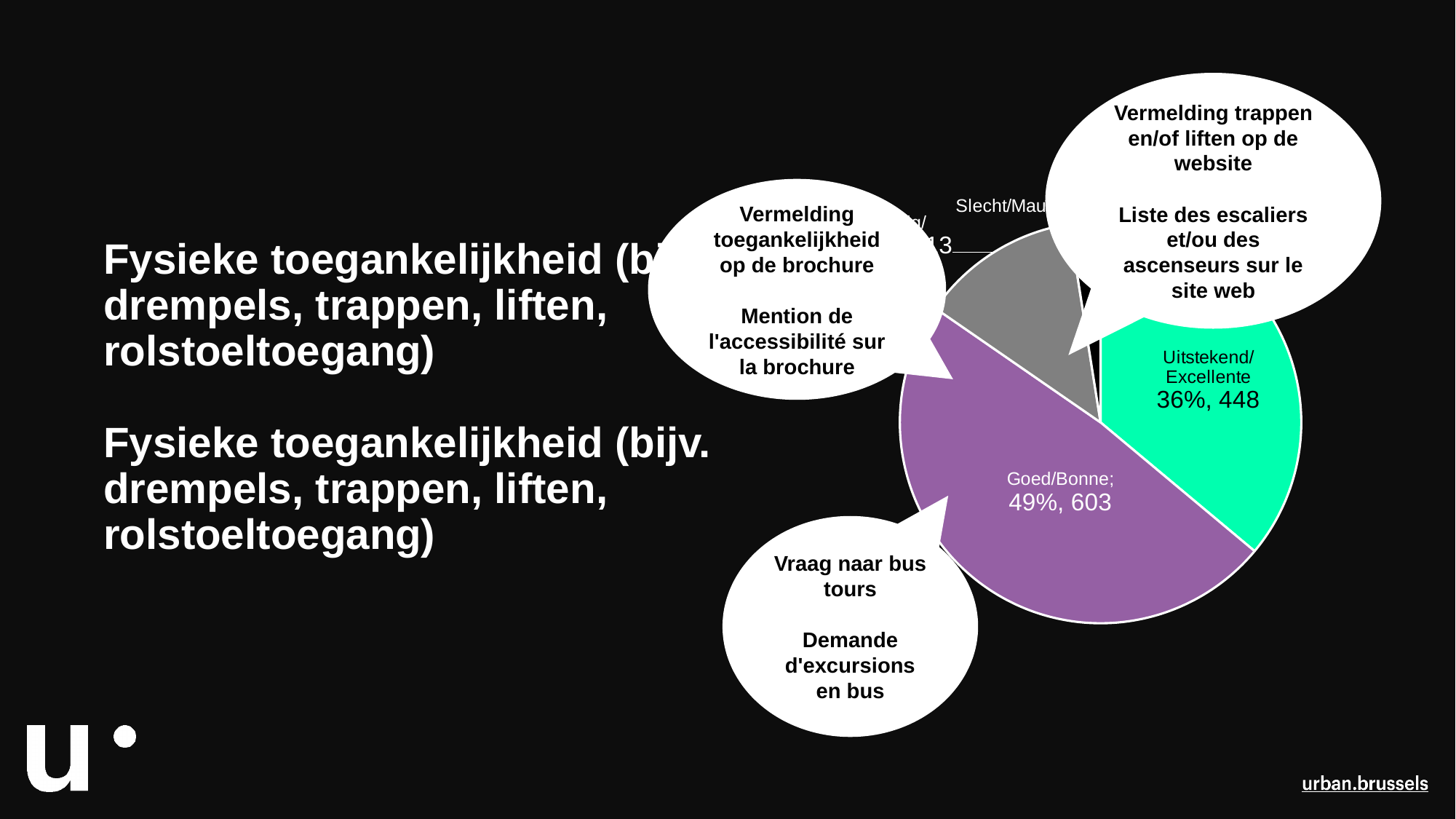
Which slice of the pie is the largest? Goed/Bonne By how many percentage points does the Goed/Bonne share exceed the Uitstekend/Excellente share? 13 What percentage share does the Goed/Bonne slice have? 49% What count is printed for the Goed/Bonne slice? 603 What kind of chart is shown on the slide? pie chart Is the share of the Uitstekend/Excellente slice greater or less than 50%? less Which is larger, the Goed/Bonne slice or the Uitstekend/Excellente slice? Goed/Bonne What count is printed for the Uitstekend/Excellente slice? 448 What colour is the Uitstekend/Excellente slice? green What colour is the Goed/Bonne slice? purple What percentage share does the Uitstekend/Excellente slice have? 36% What is the difference in count between Goed/Bonne (603) and Uitstekend/Excellente (448)? 155